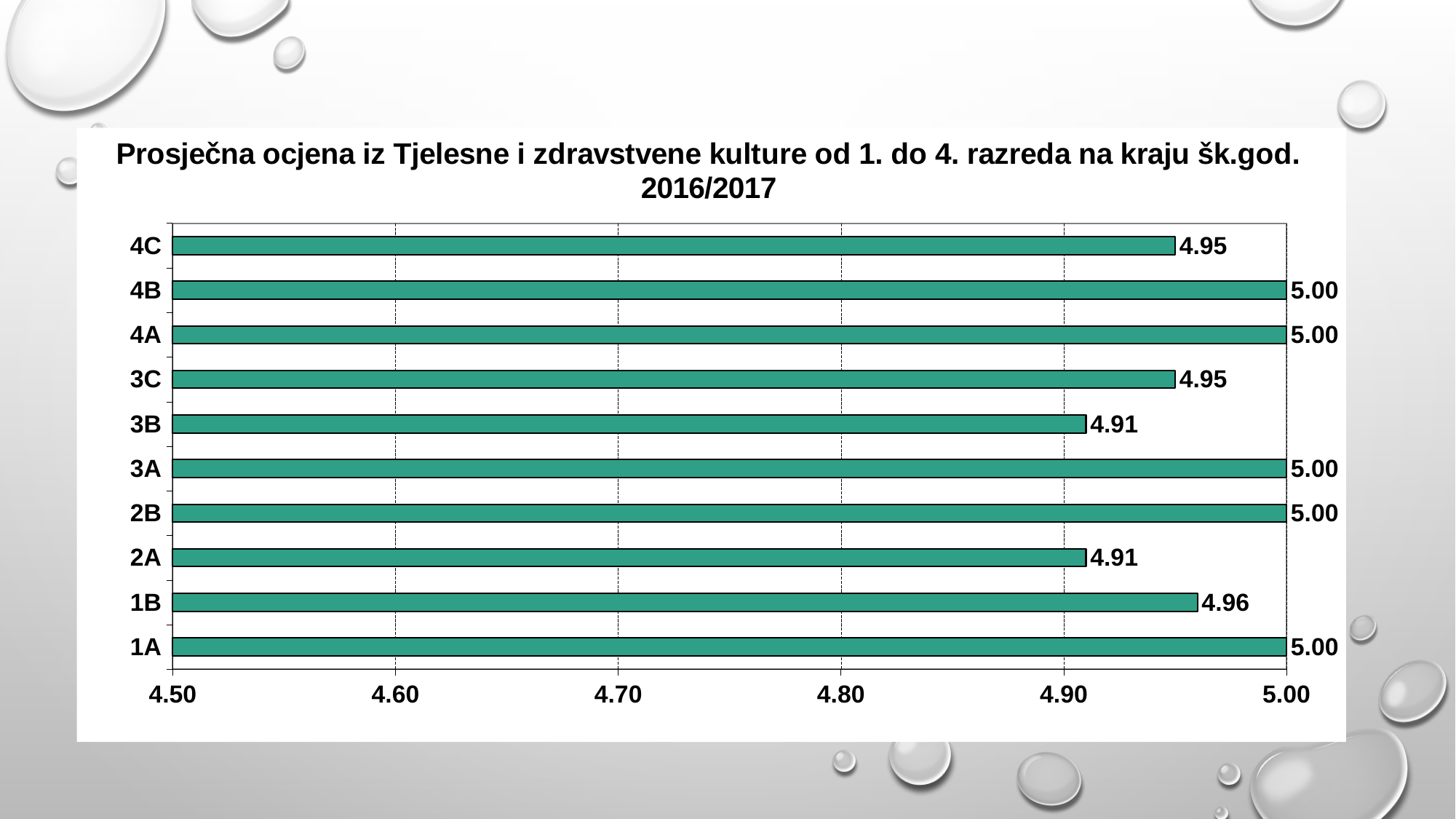
What is the average grade for class 2B? 5.00 Which class has the higher average grade, 1B or 3C? 1B How many classes are shown on the chart? 10 What is the average grade for class 4C? 4.95 What is the difference between the average grade of class 4A and class 4C? 0.05 What kind of chart is shown on the slide? Bar chart What is the average grade for class 1B? 4.96 Which class has the higher average grade, 3A or 3B? 3A What is the difference between the average grade of class 1B and class 2A? 0.05 What is the average grade for class 3B? 4.91 What is the lowest average grade shown on the chart? 4.91 What is the highest average grade shown on the chart? 5.00